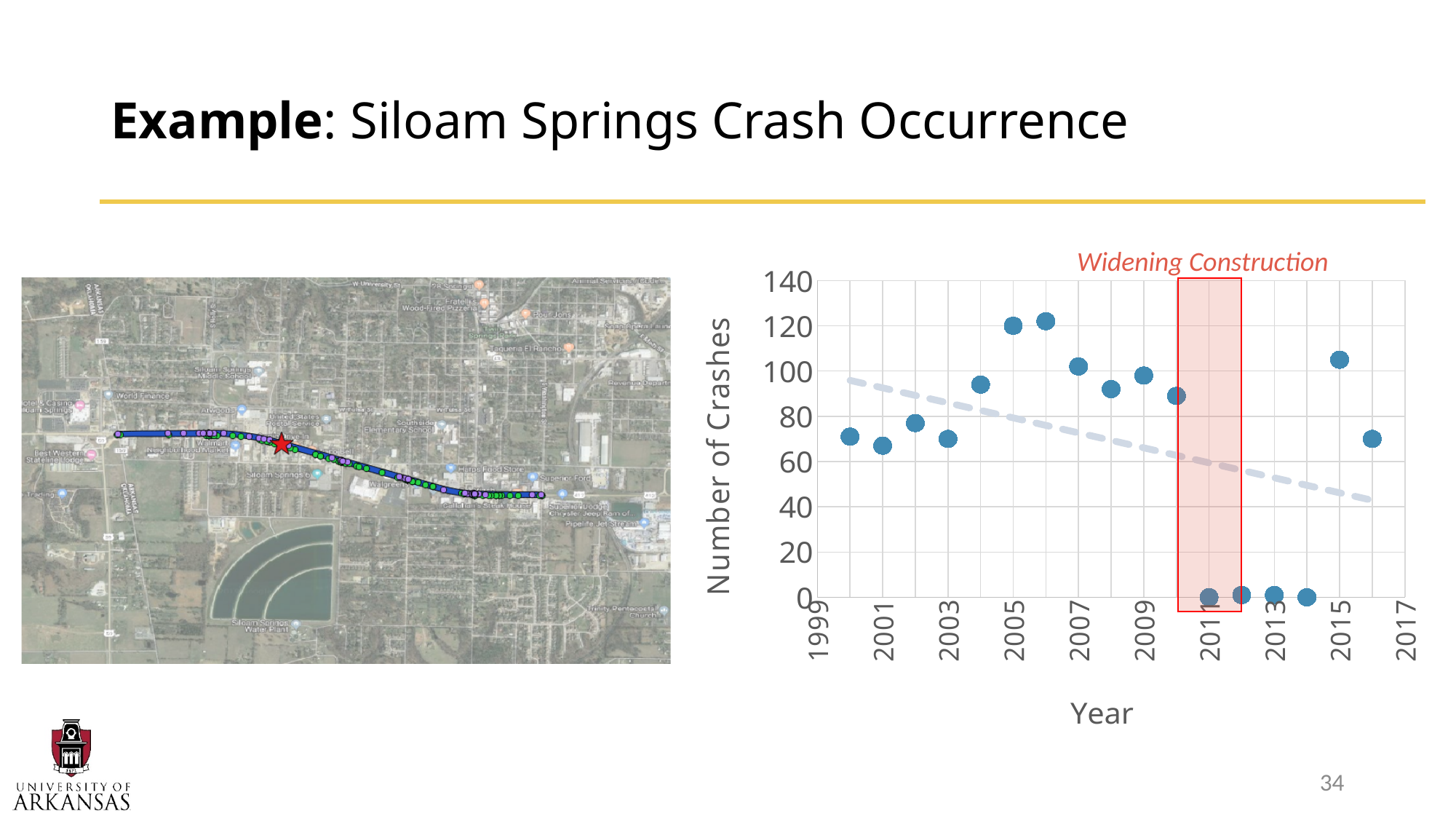
Is the number of crashes in 2005 greater or less than 100? greater Which year had more crashes, 2005 or 2001? 2005 Which year had more crashes, 2007 or 2003? 2007 Is the number of crashes in 2016 greater or less than 80? less Does the dashed trend line rise or fall from left to right across the years? fall Is the number of crashes in 2001 greater or less than 80? less How many years are plotted as data points on the chart? 17 What kind of chart is shown on the slide? scatter chart What is the label of the y axis of the chart? Number of Crashes What does the shaded red region on the chart represent? Widening Construction